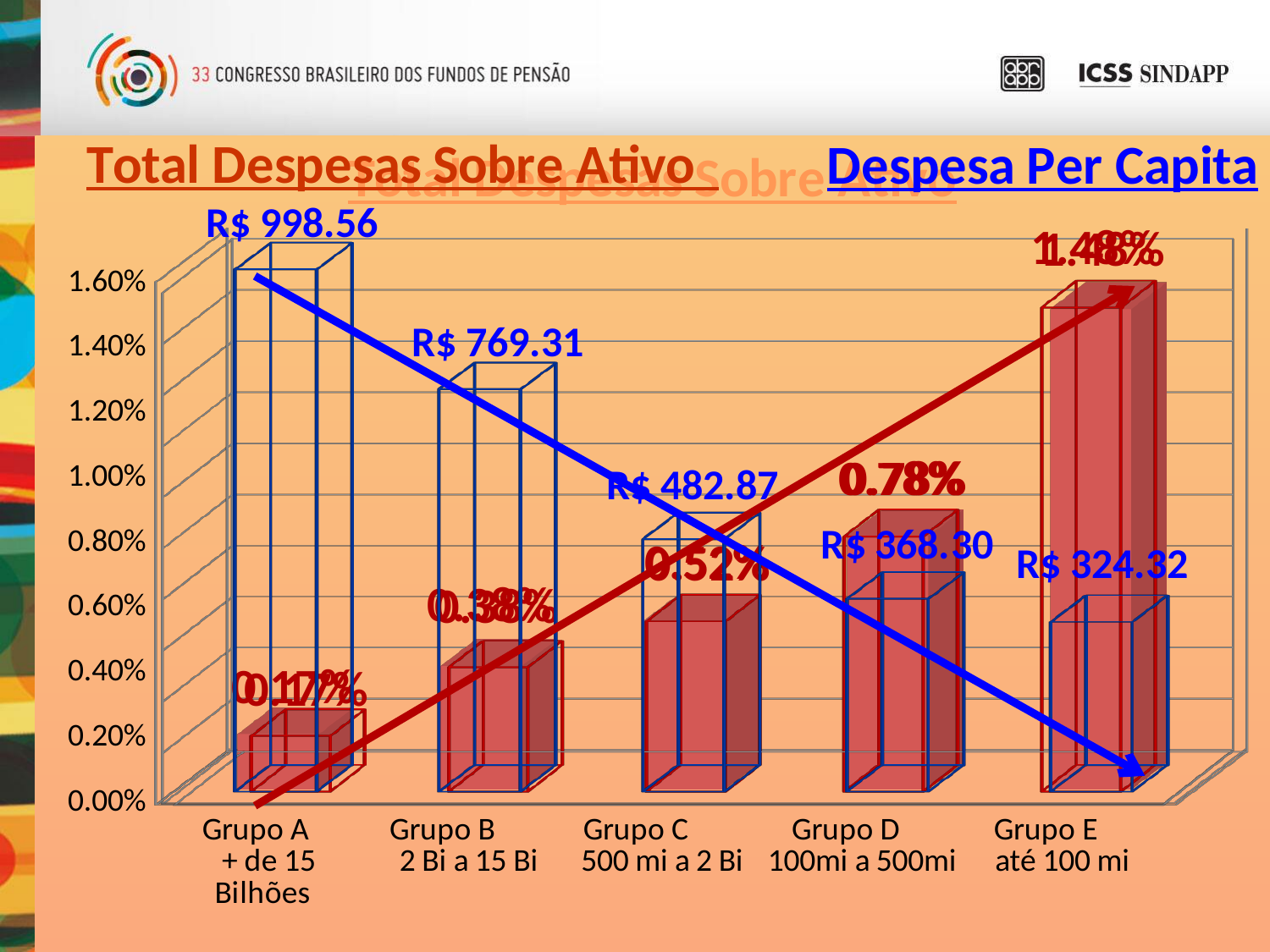
What is the Despesa Per Capita value for Grupo A? R$ 998.56 Which group has the highest Despesa Per Capita? Grupo A What is the difference in Despesa Per Capita between Grupo A and Grupo B? R$ 229.25 How many groups are shown on the x axis? 5 Is the Total Despesas Sobre Ativo value for Grupo E greater or less than 1.00%? greater What is the Despesa Per Capita value for Grupo C? R$ 482.87 Does the Despesa Per Capita rise or fall from Grupo A to Grupo E? fall What is the Total Despesas Sobre Ativo value for Grupo D? 0.78% Which has the larger Total Despesas Sobre Ativo, Grupo C or Grupo D? Grupo D What is the Despesa Per Capita value for Grupo E? R$ 324.32 Which group has the highest Total Despesas Sobre Ativo? Grupo E Which group has the lowest Despesa Per Capita? Grupo E